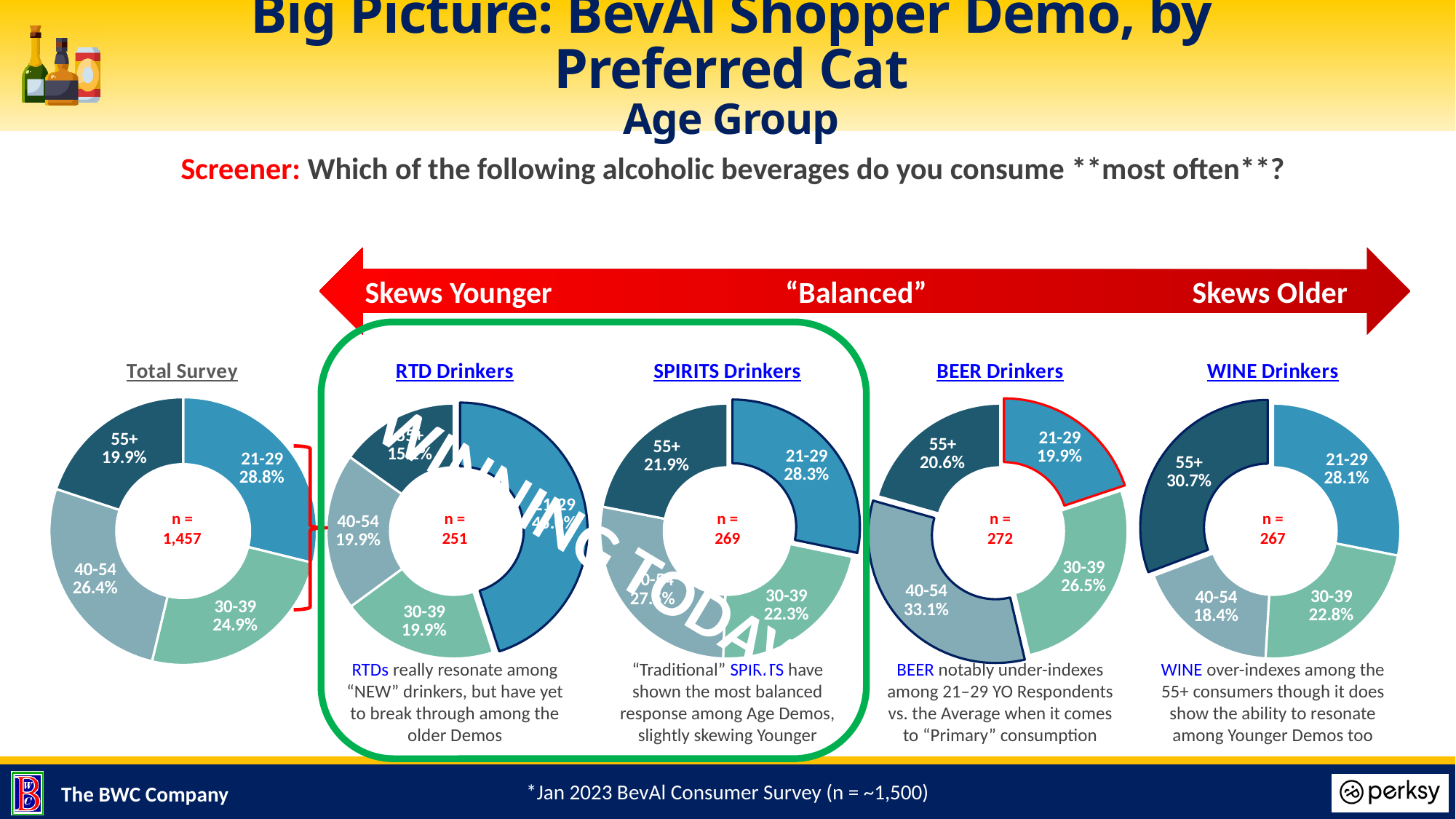
What type of chart is used for the BEER Drinkers data? Donut (pie) chart In the WINE Drinkers chart, what is the difference between the 55+ share and the 40-54 share? 12.3% What is the sample size (n) shown in the centre of the SPIRITS Drinkers chart? 269 In the BEER Drinkers chart, what is the share for the 40-54 age group? 33.1% In the BEER Drinkers chart, which age group has the largest share? 40-54 In the BEER Drinkers chart, which is larger: the 30-39 share or the 21-29 share? 30-39 In the Total Survey chart, which age group has the smallest share? 55+ In the WINE Drinkers chart, what is the share for the 55+ age group? 30.7% In the SPIRITS Drinkers chart, what is the share for the 21-29 age group? 28.3% How many age-group segments does the Total Survey chart have? 4 In the Total Survey chart, what percentage of respondents are aged 21-29? 28.8% In the WINE Drinkers chart, which age group has the smallest share? 40-54